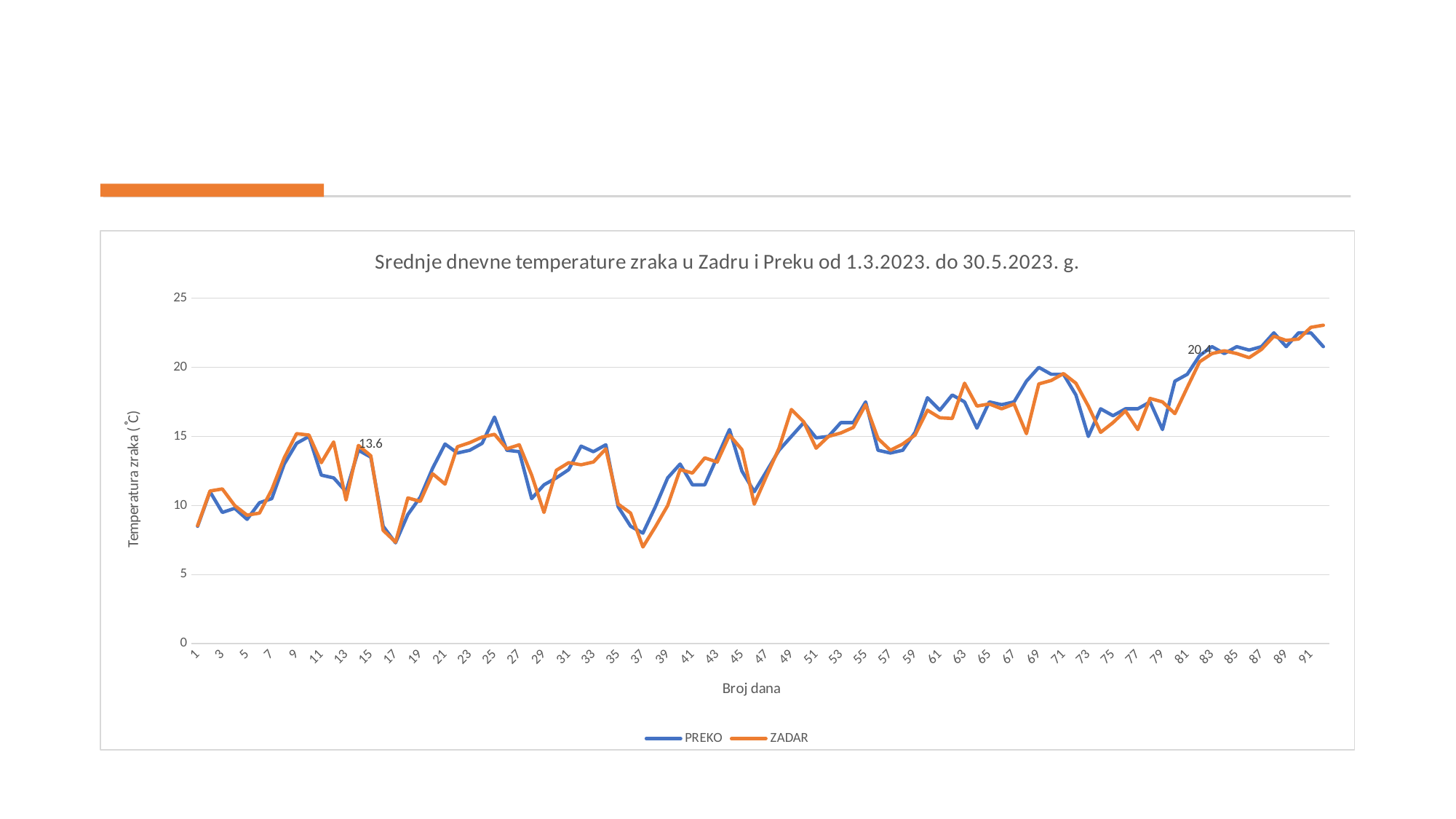
What kind of chart is shown on the slide? line chart What value is printed as a data label near day 82? 20.4 What are the two series named in the legend? PREKO and ZADAR What value is printed as a data label near day 15? 13.6 Do the temperature values generally rise or fall as the day number increases? rise Is the ZADAR value on day 63 greater or less than 15? greater On day 29, which series has the higher value, PREKO or ZADAR? PREKO Is the PREKO value on day 91 greater or less than 20? greater What is the title of the chart? Srednje dnevne temperature zraka u Zadru i Preku od 1.3.2023. do 30.5.2023. g. Is the PREKO value on day 1 greater or less than 10? less How many series does the legend list? 2